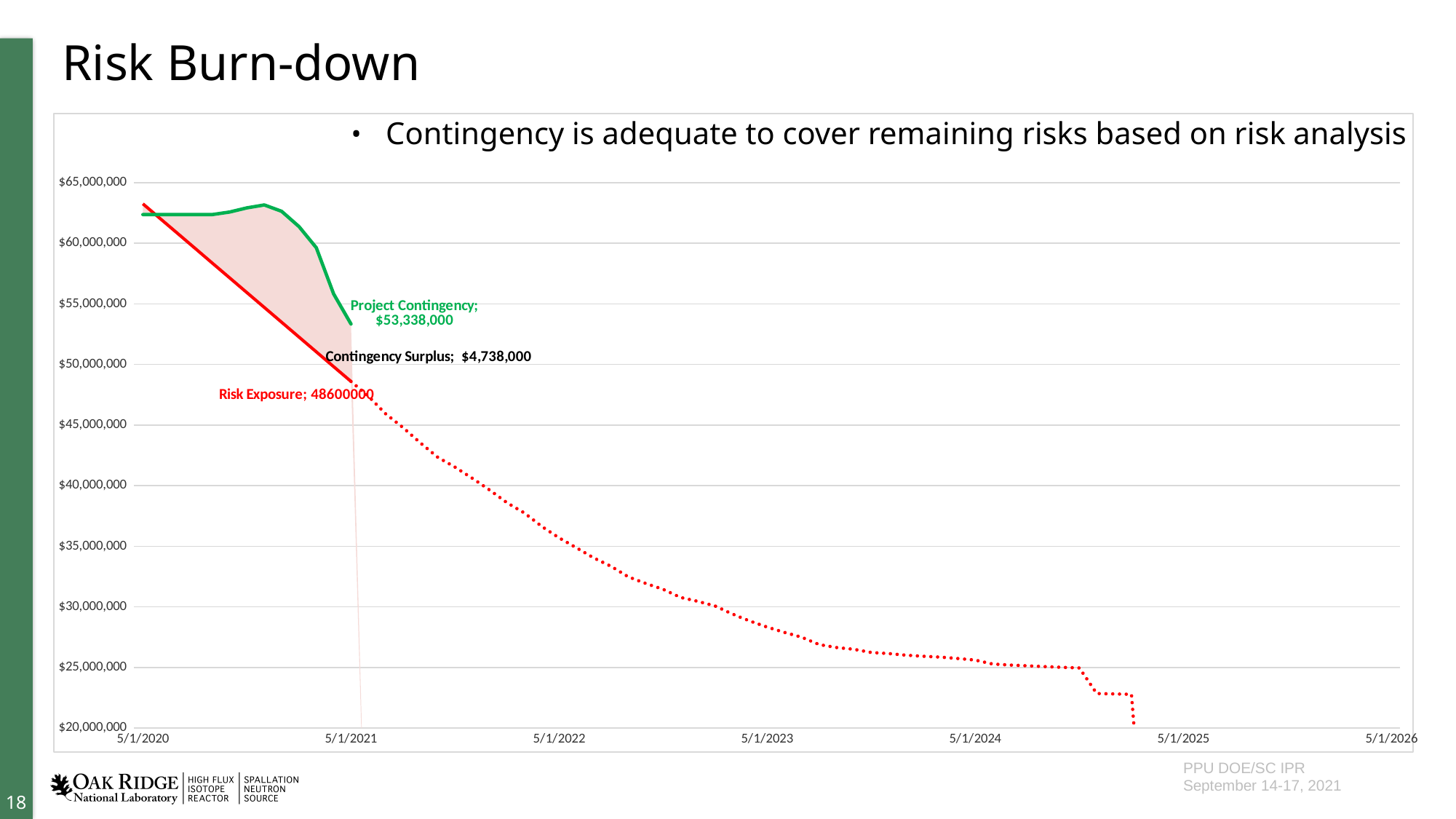
At the labeled point, which is larger: Project Contingency or Risk Exposure? Project Contingency What is the title of the slide containing the chart? Risk Burn-down What is the labeled value of Project Contingency on the chart? $53,338,000 What kind of chart is shown on the slide? combination area and line chart What is the labeled value of the Contingency Surplus? $4,738,000 How many date labels are shown on the x axis? 7 Is the Risk Exposure value at 5/1/2022 greater or less than $35,000,000? greater What is the difference between the labeled Project Contingency ($53,338,000) and the labeled Risk Exposure (48600000)? $4,738,000 Does the Risk Exposure line rise or fall from 5/1/2020 to 5/1/2025? fall What is the labeled value of Risk Exposure on the chart? 48600000 What colour is the Project Contingency line? green Is the Risk Exposure value at 5/1/2020 greater or less than $60,000,000? greater